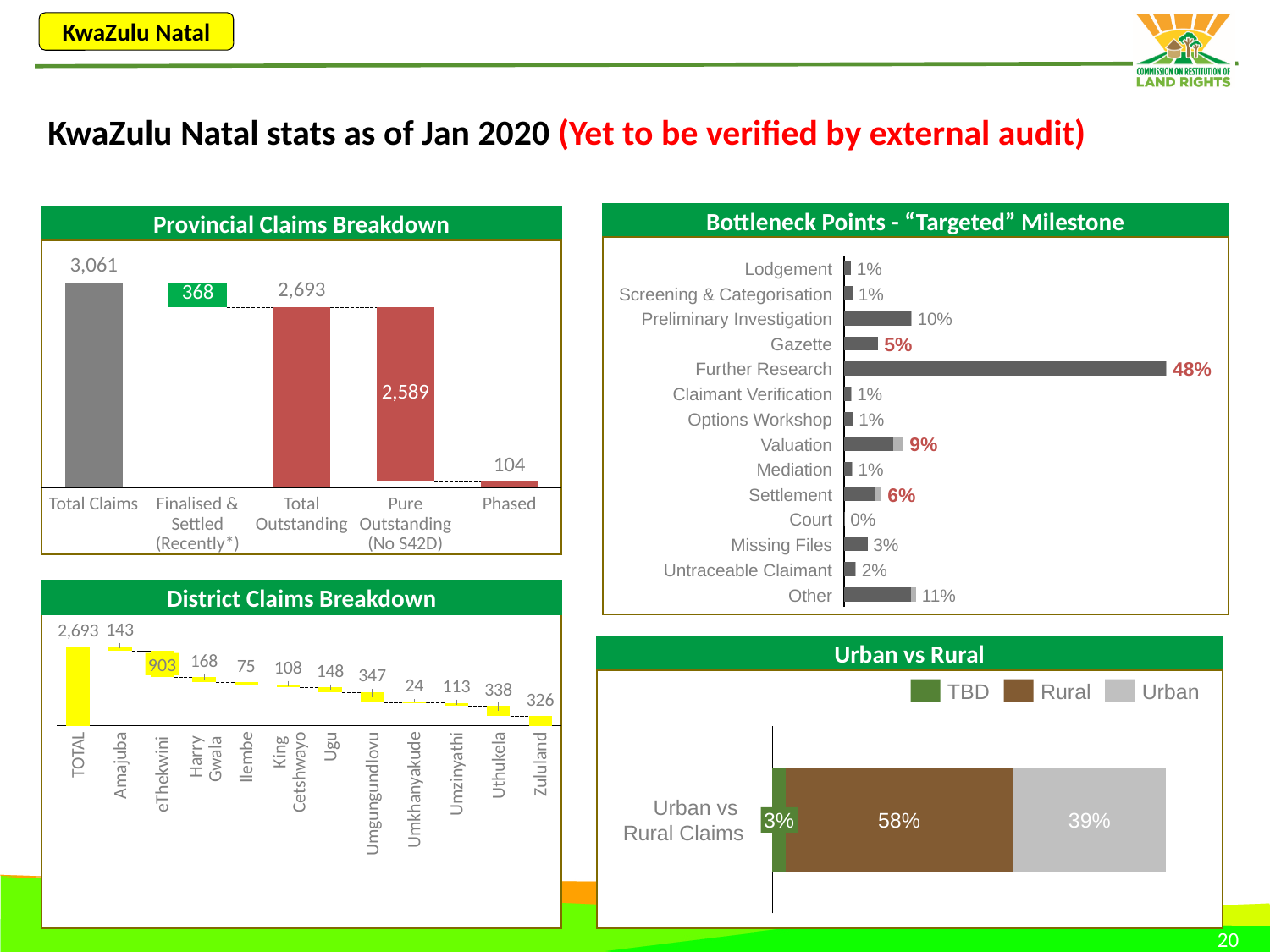
In the Provincial Claims Breakdown chart, what is the value for Total Claims? 3,061 In the District Claims Breakdown chart, what is the value for Umgungundlovu? 347 In the Bottleneck Points chart, what is the percentage for Valuation? 9% How many series does the legend of the Urban vs Rural chart list? 3 In the District Claims Breakdown chart, which is larger, Uthukela or Zululand? Uthukela In the Bottleneck Points chart, which bottleneck point has the highest percentage? Further Research In the Urban vs Rural chart, what percentage of claims are Rural? 58% How many bottleneck points are listed in the Bottleneck Points chart? 14 In the Provincial Claims Breakdown chart, what is the difference between Total Outstanding and Pure Outstanding (No S42D)? 104 In the Provincial Claims Breakdown chart, what is the value for Pure Outstanding (No S42D)? 2,589 In the District Claims Breakdown chart, which district has the lowest number of claims? Umkhanyakude In the District Claims Breakdown chart, which district has the highest number of claims? eThekwini